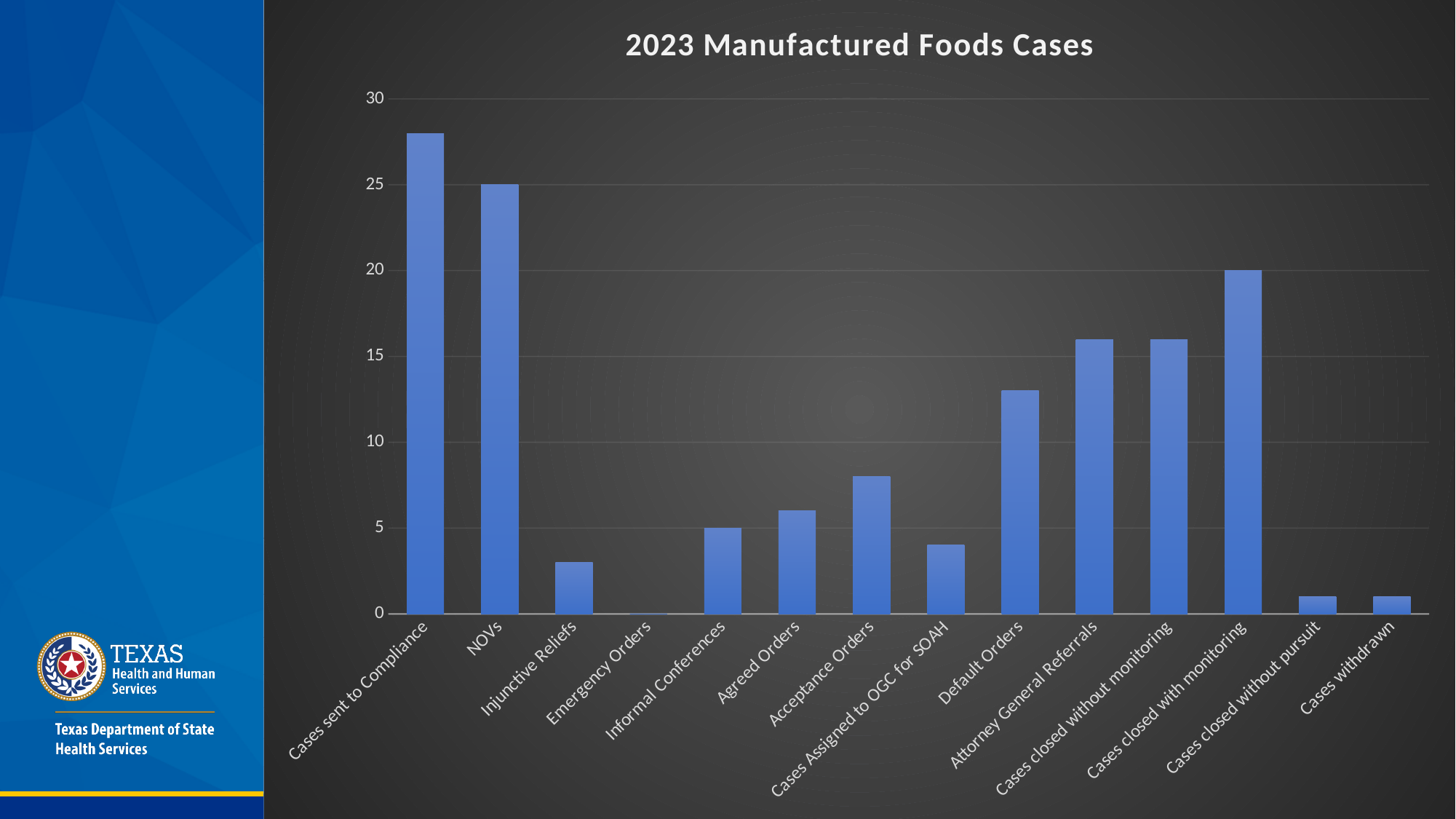
How many categories are shown on the x axis of the chart? 14 Which category has the lowest value in the chart? Emergency Orders Is the value for Cases sent to Compliance greater or less than 25? greater What is the difference between the value for NOVs and the value for Cases closed with monitoring? 5 What kind of chart is shown on the slide? bar chart Is the value for Default Orders greater or less than 10? greater What is the value for NOVs? 25 What is the value for Informal Conferences? 5 Which is larger, the value for NOVs or the value for Cases closed with monitoring? NOVs Which category has the highest value in the chart? Cases sent to Compliance What is the value for Cases closed with monitoring? 20 What is the title of the chart? 2023 Manufactured Foods Cases